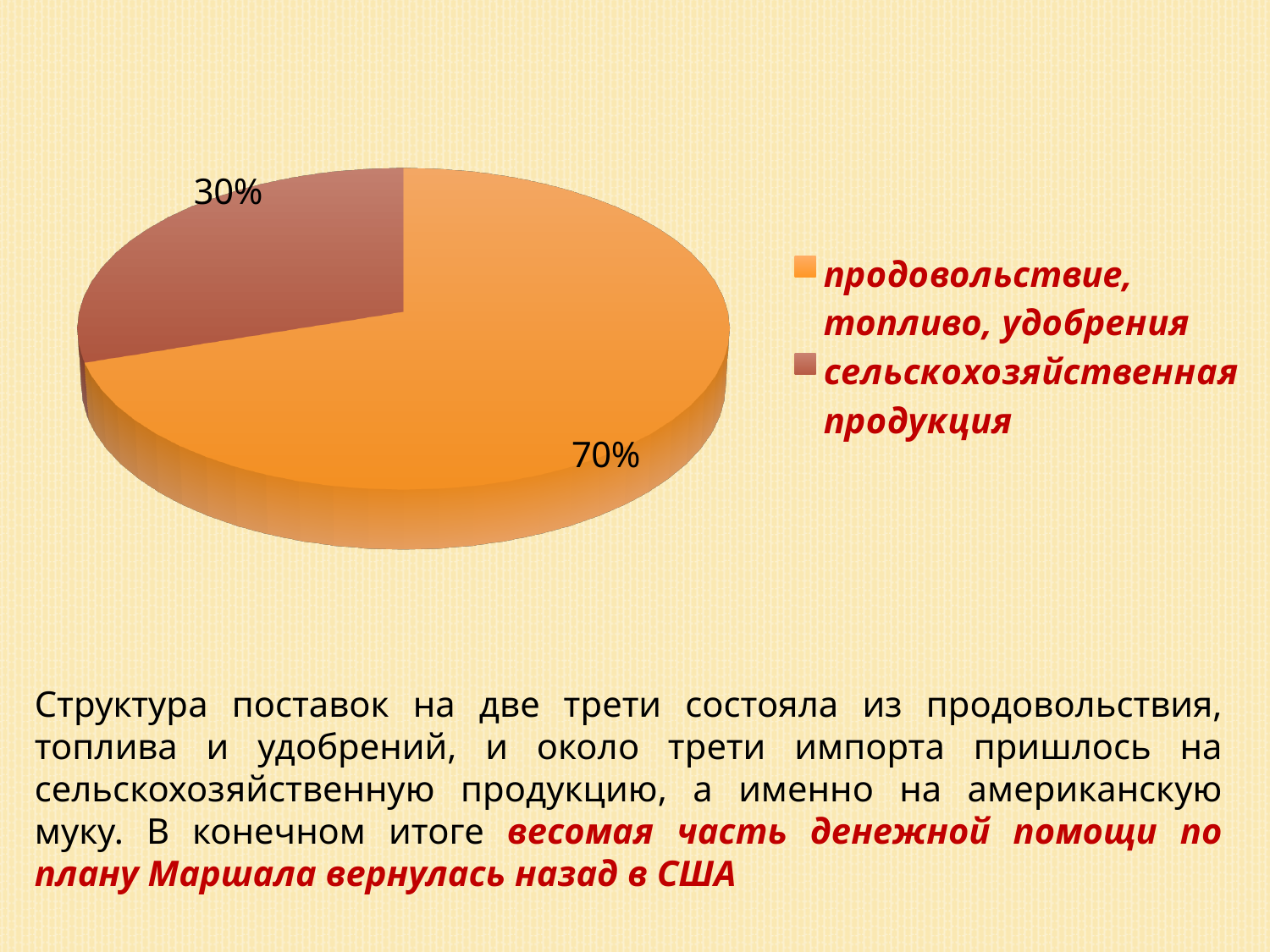
Which is larger: the share for "продовольствие, топливо, удобрения" or the share for "сельскохозяйственная продукция"? продовольствие, топливо, удобрения What kind of chart is shown on the slide? pie chart What share of the pie does "сельскохозяйственная продукция" take? 30% How many entries does the legend list? 2 Which slice of the pie is the largest? продовольствие, топливо, удобрения What colour is the slice for "сельскохозяйственная продукция"? brown What share of the pie does "продовольствие, топливо, удобрения" take? 70% Which slice of the pie is the smallest? сельскохозяйственная продукция What colour is the slice for "продовольствие, топливо, удобрения"? orange What is the difference in percentage points between the "продовольствие, топливо, удобрения" slice and the "сельскохозяйственная продукция" slice? 40 percentage points How many slices does the pie chart have? 2